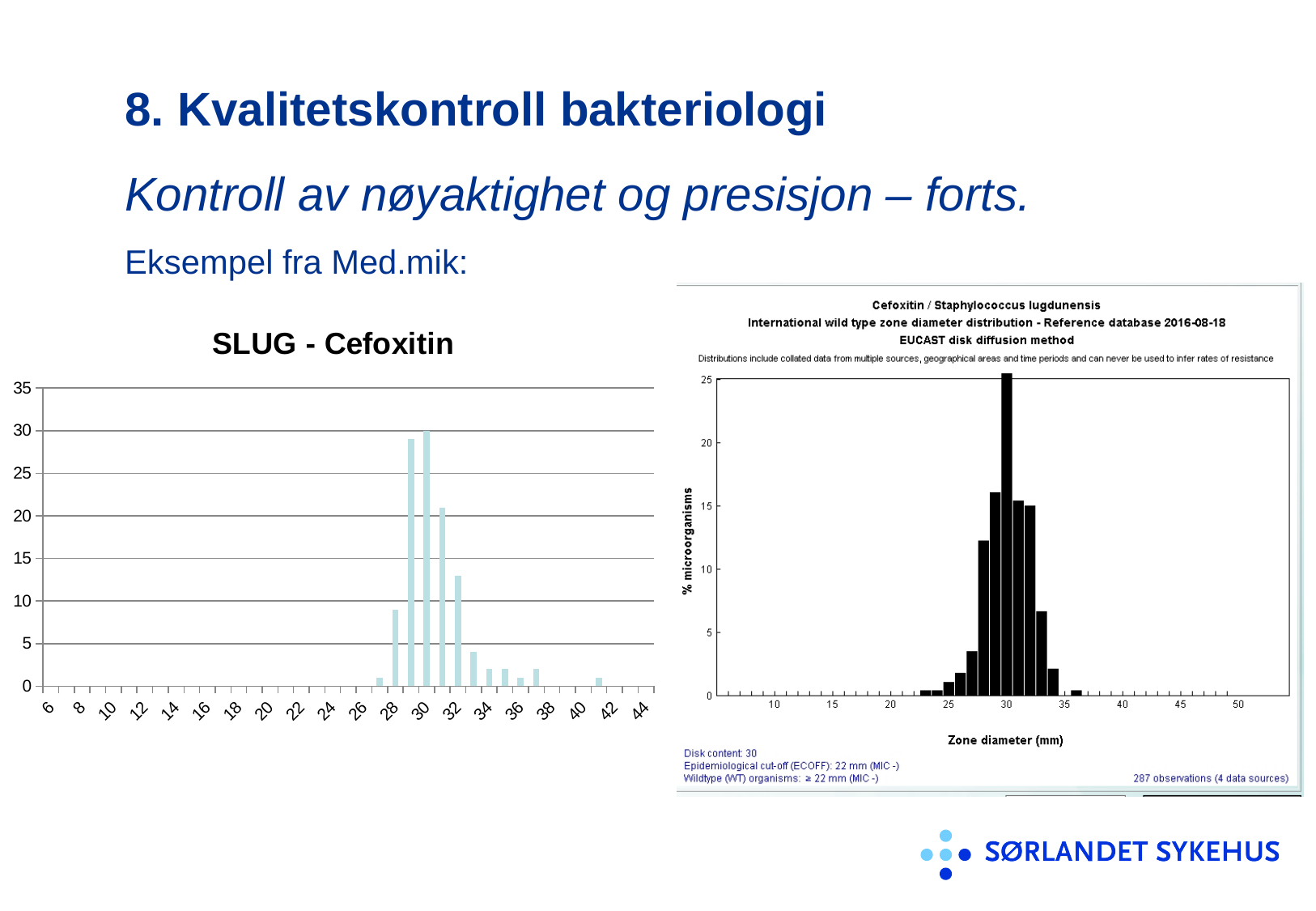
In the 'SLUG - Cefoxitin' chart, which is larger, the value for 31 or the value for 32? 31 In the 'SLUG - Cefoxitin' chart, is the value for 32 greater or less than 10? greater In the 'SLUG - Cefoxitin' chart, is the value for 31 greater or less than 15? greater In the 'Cefoxitin / Staphylococcus lugdunensis' chart on the right, which is larger, the value for zone diameter 28 or for zone diameter 33? 28 In the 'Cefoxitin / Staphylococcus lugdunensis' chart on the right, is the value for zone diameter 30 greater or less than 20? greater What kind of chart is the 'SLUG - Cefoxitin' chart on the left? bar chart In the 'Cefoxitin / Staphylococcus lugdunensis' chart on the right, which zone diameter has the highest percentage of microorganisms? 30 What is the y-axis label of the 'Cefoxitin / Staphylococcus lugdunensis' chart on the right? % microorganisms What is the title of the chart on the left side of the slide? SLUG - Cefoxitin